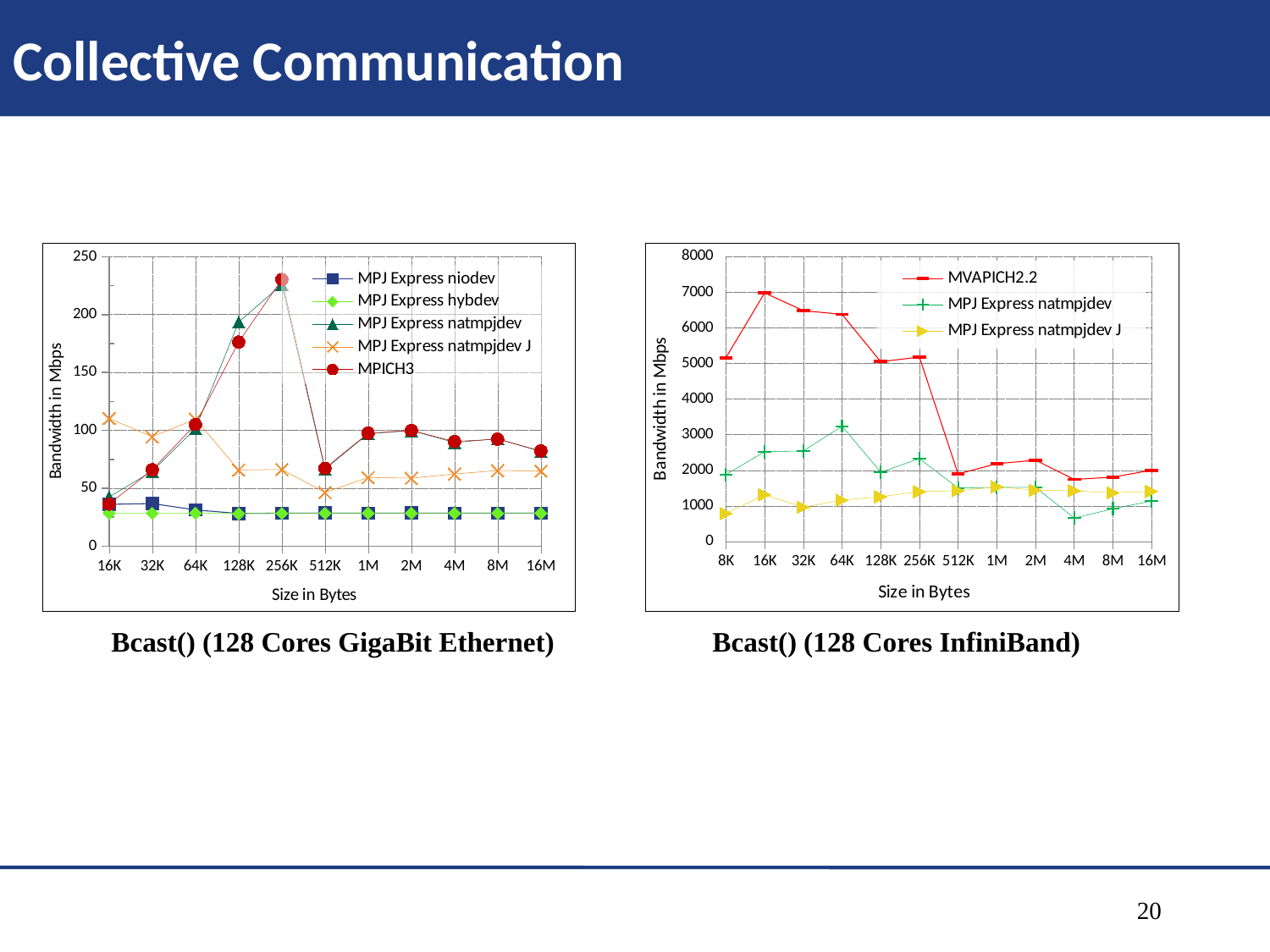
What is the y-axis label of the Bcast() (128 Cores InfiniBand) chart? Bandwidth in Mbps How many series does the legend of the Bcast() (128 Cores InfiniBand) chart list? 3 How many series does the legend of the Bcast() (128 Cores GigaBit Ethernet) chart list? 5 How many message sizes are shown on the x axis of the Bcast() (128 Cores GigaBit Ethernet) chart? 11 In the Bcast() (128 Cores InfiniBand) chart, which series has the highest bandwidth at 16K? MVAPICH2.2 What type of chart is the Bcast() (128 Cores GigaBit Ethernet) chart? line chart How many message sizes are shown on the x axis of the Bcast() (128 Cores InfiniBand) chart? 12 In the Bcast() (128 Cores InfiniBand) chart, does the MVAPICH2.2 line rise or fall from 256K to 512K? fall In the Bcast() (128 Cores InfiniBand) chart, is the value for MPJ Express natmpjdev J at 8K greater or less than 1000? less In the Bcast() (128 Cores GigaBit Ethernet) chart, is the value for MPICH3 at 256K greater or less than 200? greater In the Bcast() (128 Cores GigaBit Ethernet) chart, which is larger at 16K: MPJ Express natmpjdev J or MPICH3? MPJ Express natmpjdev J In the Bcast() (128 Cores InfiniBand) chart, is the value for MVAPICH2.2 at 16K greater or less than 6000? greater